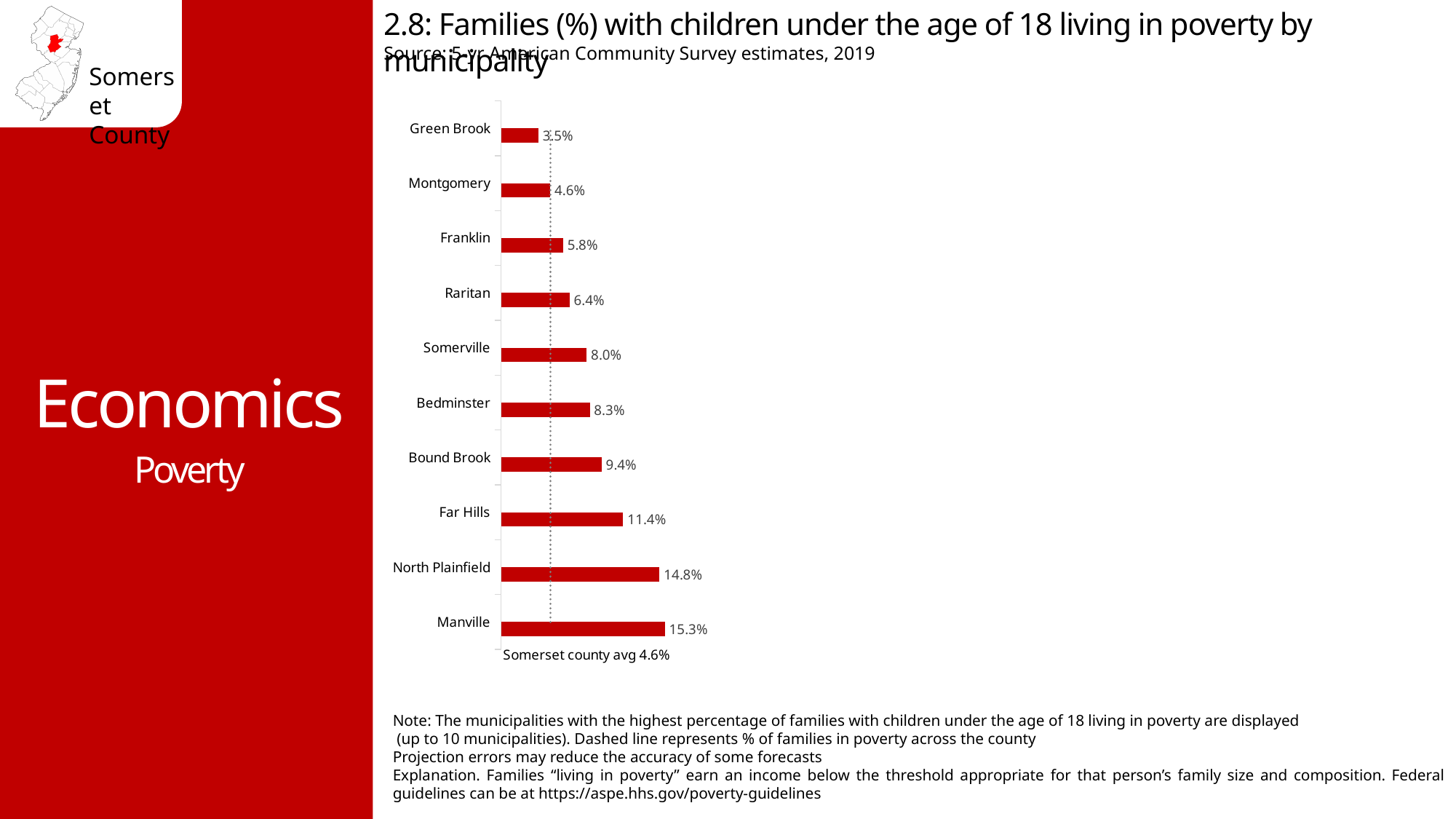
How many municipalities are shown on the chart? 10 Which municipality has the highest percentage of families with children under 18 living in poverty? Manville What is the value shown for North Plainfield? 14.8% What is the difference between the values for Manville and Green Brook? 11.8% Which municipality's value equals the Somerset county average of 4.6%? Montgomery What kind of chart is shown on the slide? Bar chart What percentage of families with children under 18 are living in poverty in Manville? 15.3% What is the difference between the values for Far Hills and Bound Brook? 2.0% Which has a higher value, Bedminster or Raritan? Bedminster What is the value shown for Somerville? 8.0% Which municipality has the lowest percentage shown on the chart? Green Brook What is the Somerset county average shown by the dashed line? 4.6%